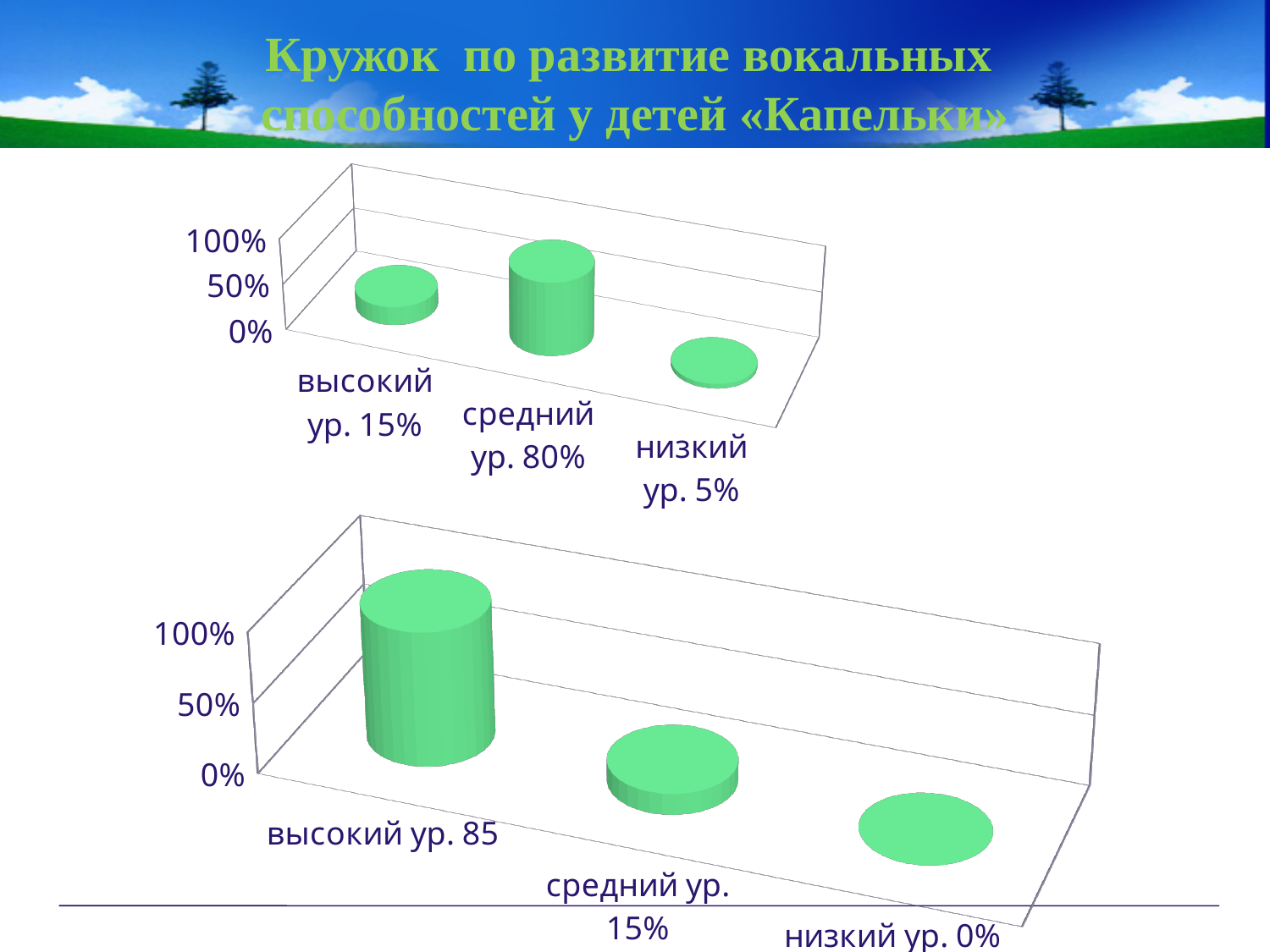
In the bottom chart, is the value for the high level greater or less than 50%? greater What kind of chart is the top chart? bar chart In the top chart, what is the value for the low level (низкий ур.)? 5% In the bottom chart, which category has the highest value? высокий ур. In the top chart, which category has the highest value? средний ур. In the top chart, which category has the lowest value? низкий ур. How many categories does the bottom chart show? 3 In the bottom chart, what is the value for the low level (низкий ур.)? 0% In the top chart, what is the value for the middle level (средний ур.)? 80%